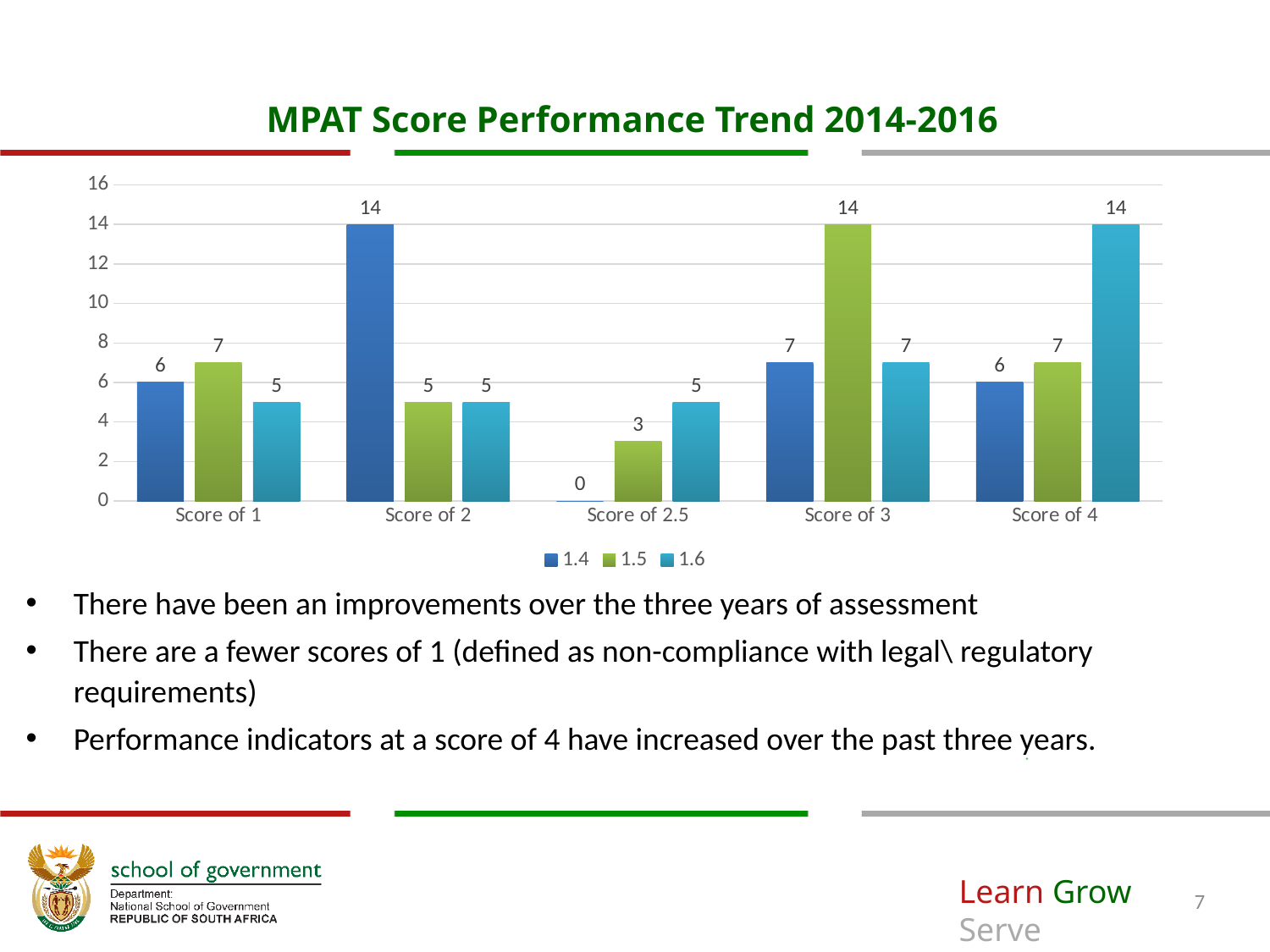
How many series does the legend list? 3 How many categories are shown on the x axis? 5 What kind of chart is shown on the slide? Bar chart Which category has the lowest value for series 1.4? Score of 2.5 What is the value for series 1.4 at Score of 2? 14 Which category has the highest value for series 1.5? Score of 3 What is the value for series 1.4 at Score of 2.5? 0 At Score of 1, which series has the larger value, 1.4 or 1.5? 1.5 What is the title of the chart? MPAT Score Performance Trend 2014-2016 What is the value for series 1.5 at Score of 2.5? 3 What is the value for series 1.6 at Score of 4? 14 What is the difference between the 1.6 value and the 1.4 value at Score of 4? 8